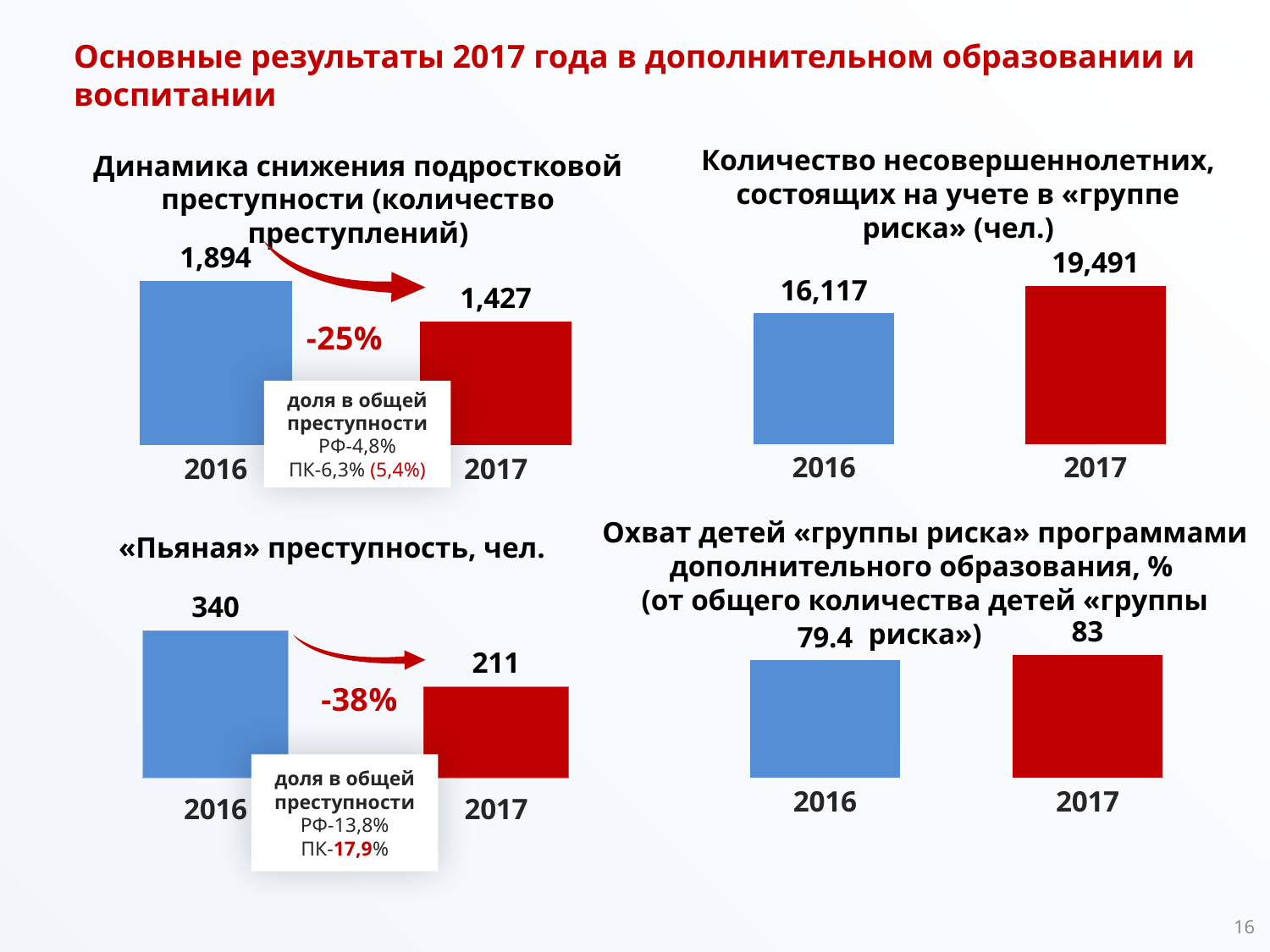
In the top-right chart on minors in the «группа риска», what is the value for 2017? 19,491 In the top-left chart on teenage crime, what is the difference between the 2016 and 2017 values? 467 In the bottom-left chart «Пьяная» преступность, what is the difference between the 2016 and 2017 values? 129 What kind of chart is the bottom-left chart «Пьяная» преступность? bar chart In the bottom-right chart on coverage of «группа риска» children, do the values rise or fall from 2016 to 2017? rise In the top-left chart on teenage crime (Динамика снижения подростковой преступности), what is the value for 2016? 1,894 In the top-left chart on teenage crime, what percentage change is printed between the two bars? -25% In the bottom-left chart «Пьяная» преступность, what is the value for 2016? 340 In the top-left chart on teenage crime, what is the value for 2017? 1,427 In the top-right chart on minors in the «группа риска», which year has the higher value? 2017 In the top-right chart on minors in the «группа риска», what is the difference between the 2017 and 2016 values? 3,374 In the bottom-right chart on coverage of «группа риска» children by additional education programmes, what is the value for 2017? 83